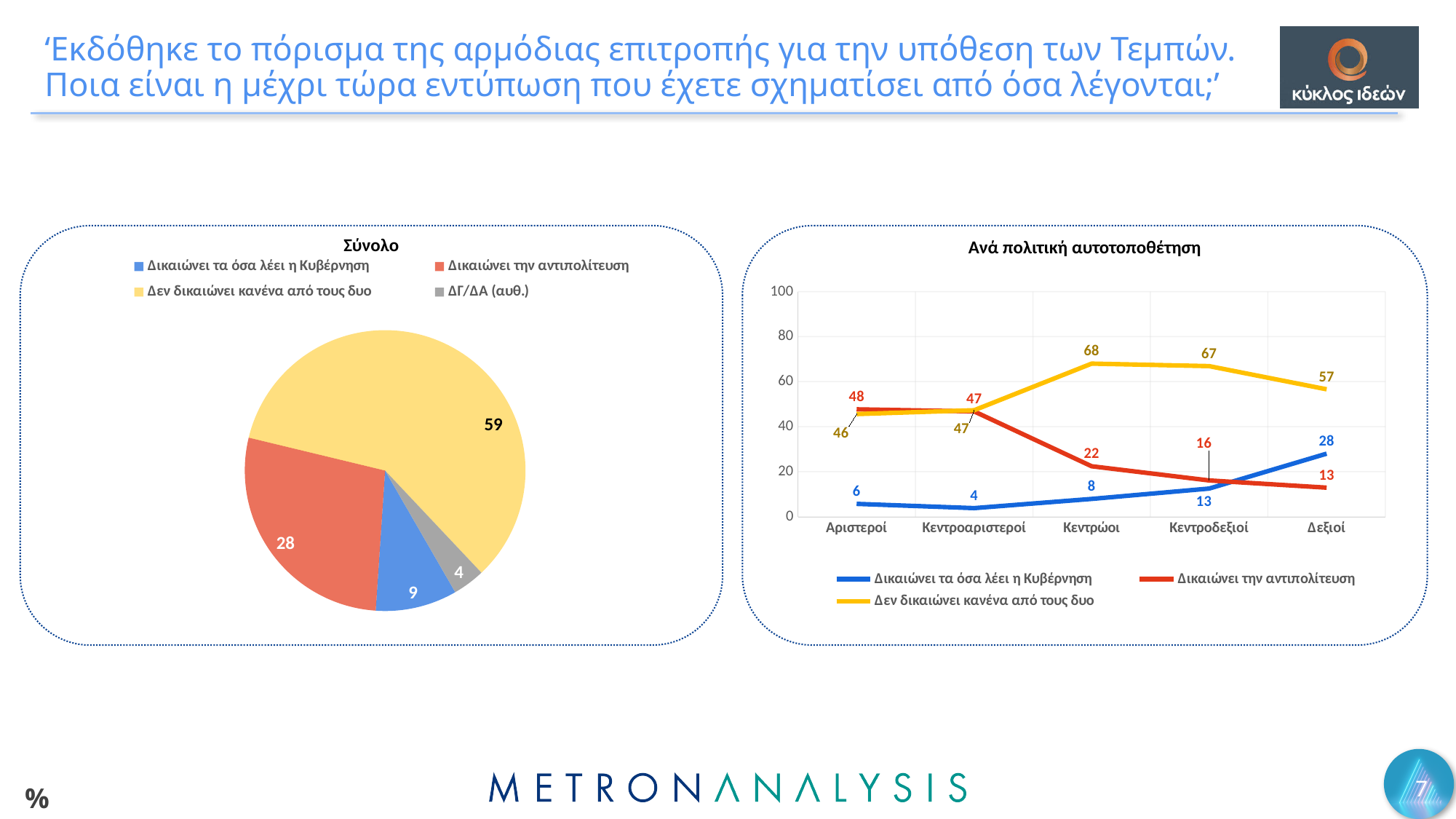
In the 'Σύνολο' pie chart, what is the value for 'Δεν δικαιώνει κανένα από τους δυο'? 59 In the 'Ανά πολιτική αυτοτοποθέτηση' chart, what is the value for 'Δεν δικαιώνει κανένα από τους δυο' among 'Κεντρώοι'? 68 In the 'Ανά πολιτική αυτοτοποθέτηση' chart, what is the value for 'Δικαιώνει τα όσα λέει η Κυβέρνηση' among 'Δεξιοί'? 28 In the 'Σύνολο' pie chart, what is the difference between 'Δικαιώνει την αντιπολίτευση' and 'Δικαιώνει τα όσα λέει η Κυβέρνηση'? 19 In the 'Ανά πολιτική αυτοτοποθέτηση' chart, which is larger among 'Κεντροδεξιοί': 'Δικαιώνει την αντιπολίτευση' or 'Δικαιώνει τα όσα λέει η Κυβέρνηση'? Δικαιώνει την αντιπολίτευση In the 'Σύνολο' pie chart, which category has the smallest slice? ΔΓ/ΔΑ (αυθ.) In the 'Ανά πολιτική αυτοτοποθέτηση' chart, how many categories are on the x axis? 5 In the 'Ανά πολιτική αυτοτοποθέτηση' chart, how many series does the legend list? 3 In the 'Ανά πολιτική αυτοτοποθέτηση' chart, does the value for 'Δικαιώνει την αντιπολίτευση' rise or fall from 'Αριστεροί' to 'Δεξιοί'? Fall What kind of chart is the 'Σύνολο' chart? Pie chart In the 'Σύνολο' pie chart, what is the value for 'Δικαιώνει την αντιπολίτευση'? 28 In the 'Ανά πολιτική αυτοτοποθέτηση' chart, which category has the highest value for 'Δικαιώνει την αντιπολίτευση'? Αριστεροί